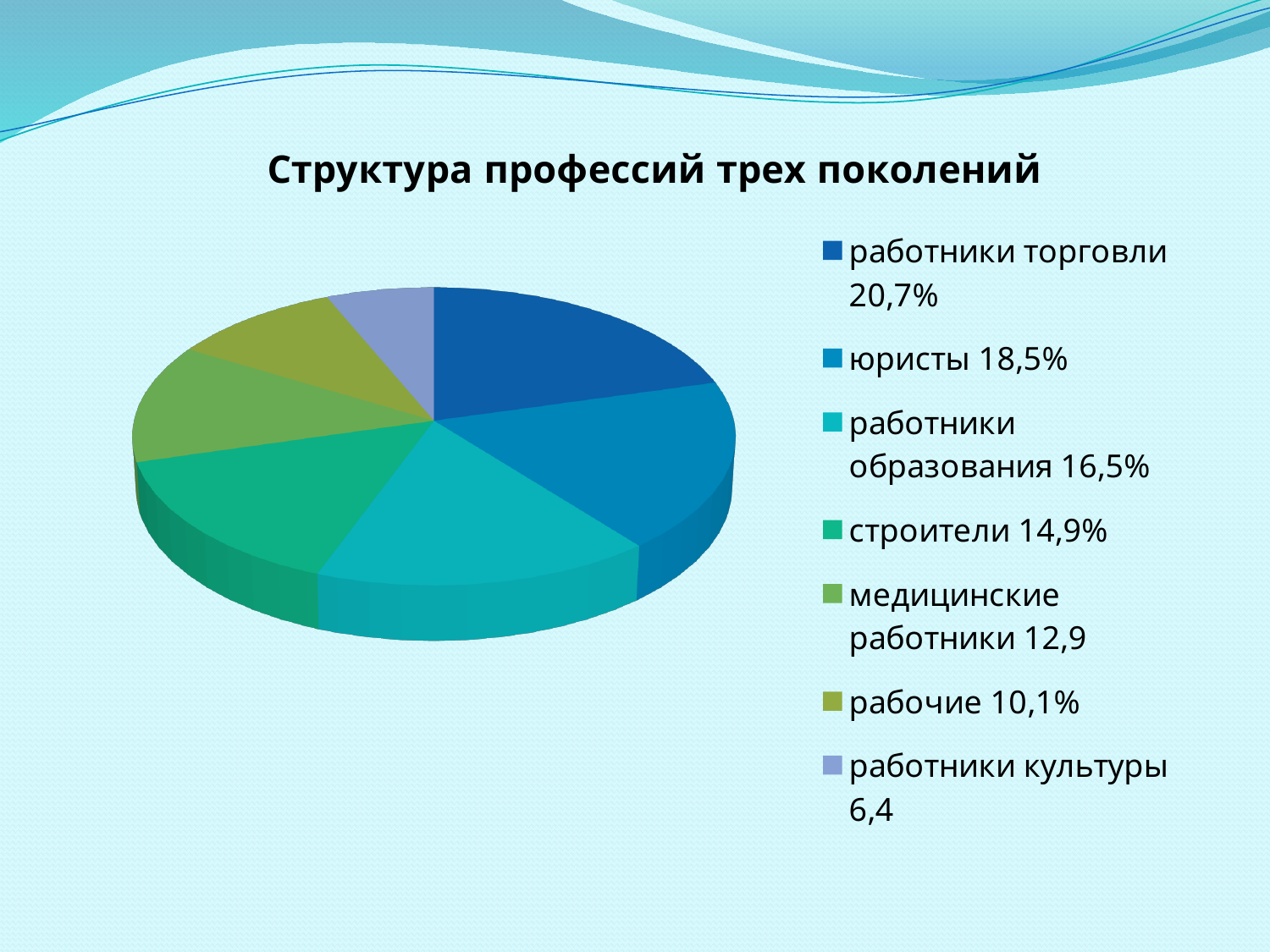
What is the difference between the values for работники торговли and юристы? 2,2 What value is shown for медицинские работники? 12,9 What is the title of the chart? Структура профессий трех поколений What share of the pie do работники культуры have? 6,4 What value is shown for юристы? 18,5% Which category has the smallest share of the pie? работники культуры What kind of chart is shown on the slide? pie chart What value is shown for работники торговли? 20,7% Which is larger, the value for работники образования or the value for рабочие? работники образования How many categories does the pie chart have? 7 What value is shown for строители? 14,9% Which category has the largest share of the pie? работники торговли